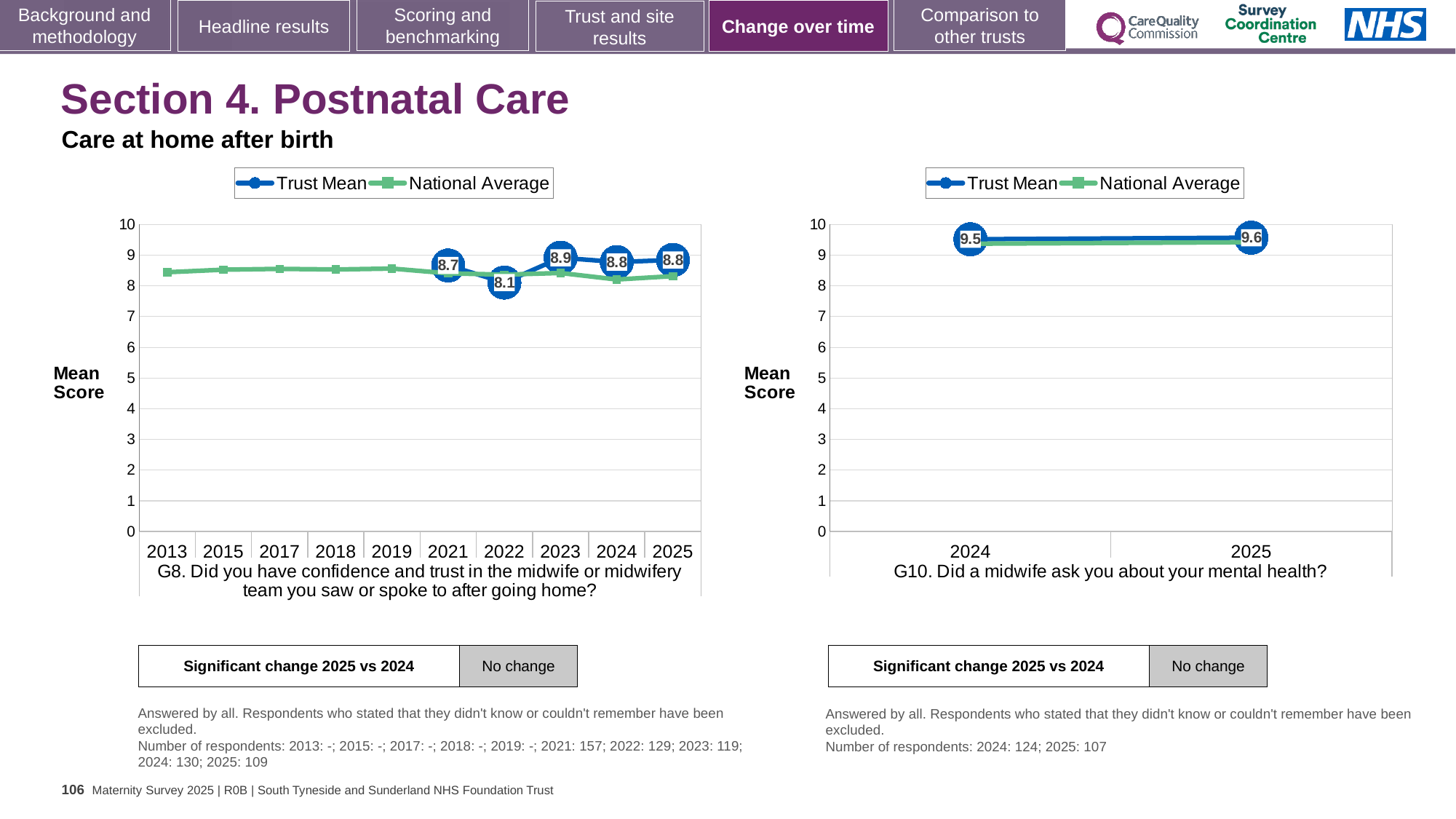
In the G8 chart on the left, what is the Trust Mean score for 2025? 8.8 In the G8 chart on the left, which year has the lowest labelled Trust Mean score? 2022 In the G10 chart on the right, does the Trust Mean rise or fall from 2024 to 2025? rise What kind of chart is the G8 chart on the left? line chart In the G10 chart on the right, what is the Trust Mean score for 2024? 9.5 How many years are shown on the x axis of the G8 chart on the left? 10 In the G8 chart on the left, which year has the highest labelled Trust Mean score? 2023 How many series does the legend of the G10 chart on the right list? 2 In the G8 chart on the left, what is the difference between the Trust Mean scores for 2023 and 2022? 0.8 In the G8 chart on the left, is the National Average for 2013 greater or less than 8? greater In the G10 chart on the right, is the Trust Mean score for 2025 higher or lower than for 2024? higher In the G8 chart on the left, what is the Trust Mean score for 2022? 8.1